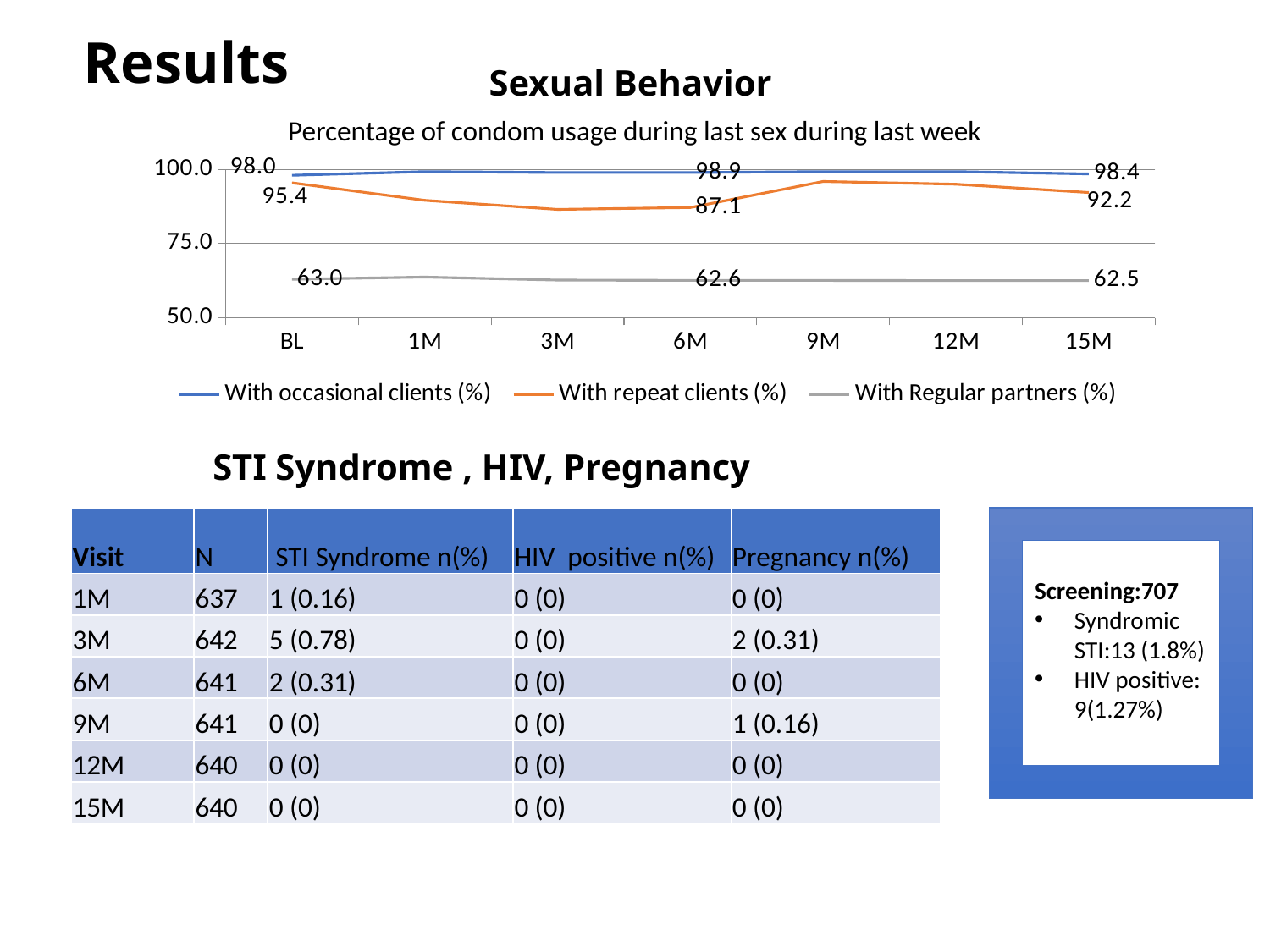
What is the value for 'With occasional clients (%)' at 6M in the condom usage chart? 98.9 What type of chart is used to show the percentage of condom usage during last sex during last week? line chart How many series does the legend of the condom usage chart list? 3 In the condom usage chart, which series has the lowest values across all time points? With Regular partners (%) In the condom usage chart, is the value for 'With repeat clients (%)' at 3M greater or less than 75.0? greater In the condom usage chart, which is larger at 15M: 'With occasional clients (%)' or 'With repeat clients (%)'? With occasional clients (%) How many time points are shown on the x axis of the condom usage chart? 7 What is the title of the line chart on the slide? Percentage of condom usage during last sex during last week What is the value for 'With repeat clients (%)' at BL in the condom usage chart? 95.4 What is the value for 'With Regular partners (%)' at 15M in the condom usage chart? 62.5 In the condom usage chart, what is the difference between 'With occasional clients (%)' and 'With repeat clients (%)' at 6M? 11.8 What is the value for 'With repeat clients (%)' at 6M in the condom usage chart? 87.1